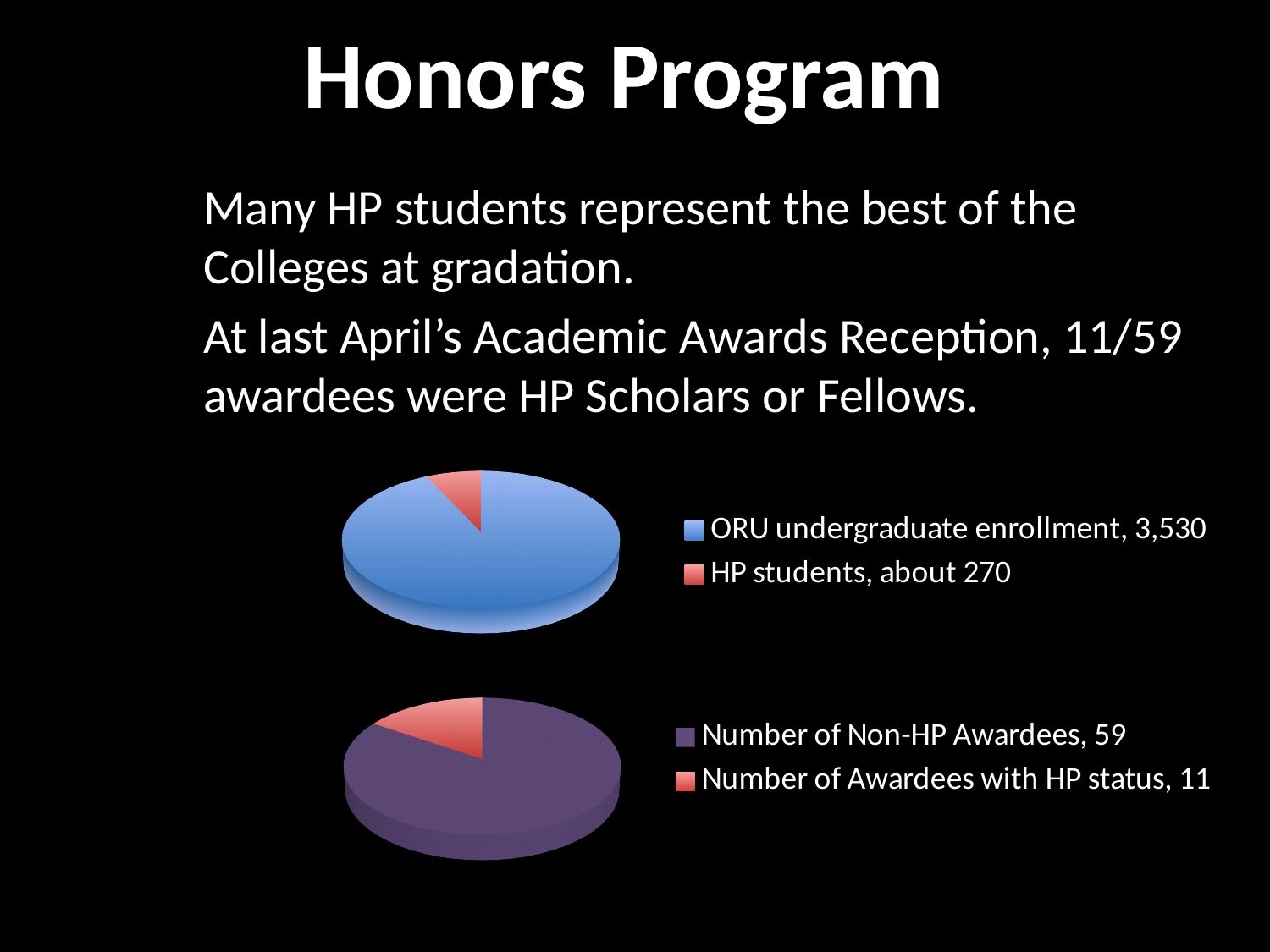
How many slices does the top pie chart have? 2 In the bottom pie chart, what is the total number of awardees across both slices? 70 What kind of chart is the top chart on the slide? pie chart In the top pie chart, which category has the largest slice? ORU undergraduate enrollment In the bottom pie chart, what is the Number of Non-HP Awardees? 59 In the top pie chart, what value is given for ORU undergraduate enrollment? 3,530 In the bottom pie chart, what is the difference between the Number of Non-HP Awardees and the Number of Awardees with HP status? 48 What colour is the slice for HP students in the top pie chart? red In the bottom pie chart, which is larger: Number of Non-HP Awardees or Number of Awardees with HP status? Number of Non-HP Awardees In the bottom pie chart, which category has the smallest slice? Number of Awardees with HP status How many entries does the legend of the top pie chart list? 2 In the bottom pie chart, what is the Number of Awardees with HP status? 11